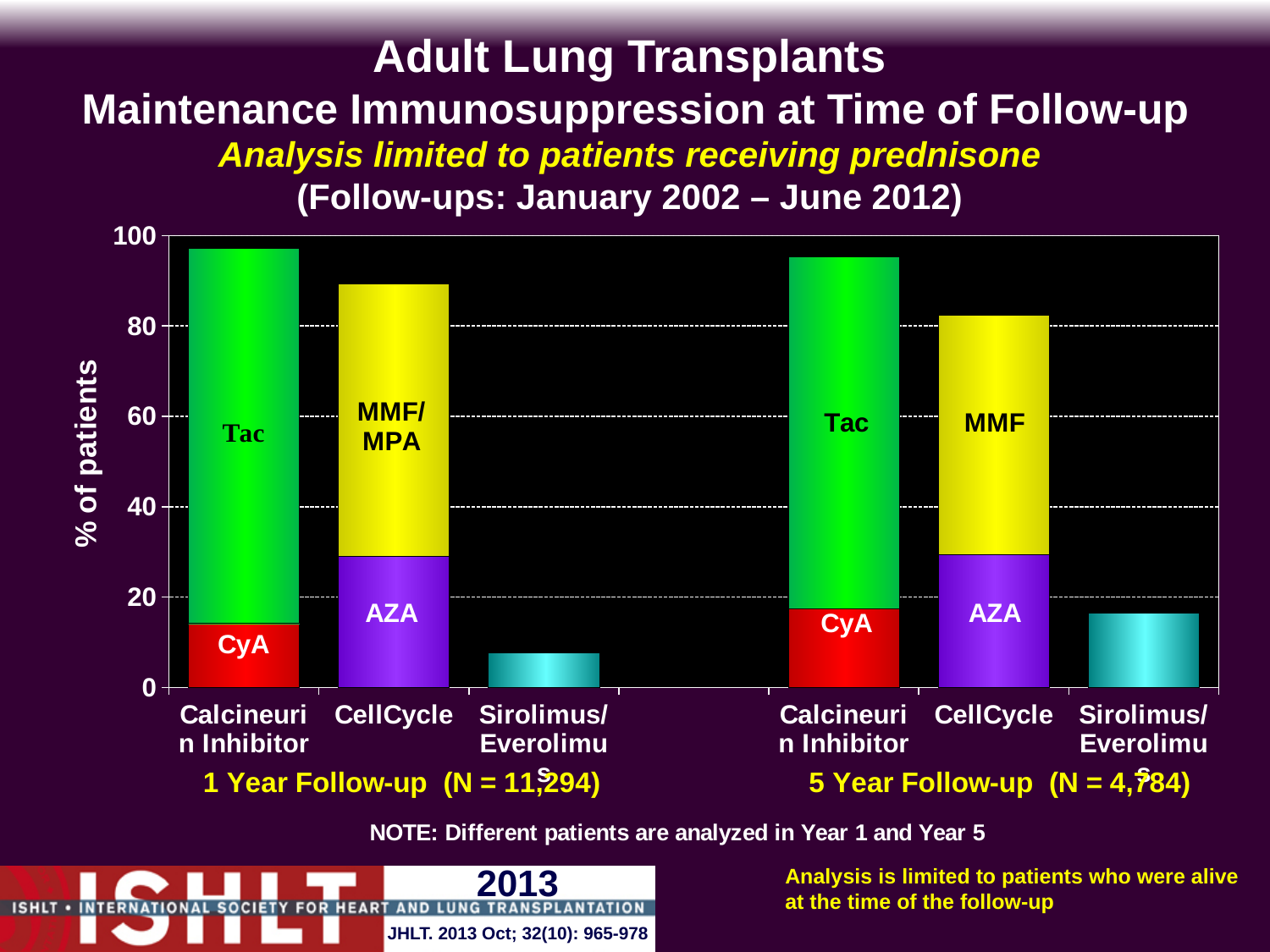
Which follow-up group has the taller CellCycle bar, 1 Year or 5 Year? 1 Year Follow-up Is the total value of the Calcineurin Inhibitor bar in the 1 Year Follow-up group greater or less than 80? greater What is the label of the y axis? % of patients Is the value for Sirolimus/Everolimus in the 5 Year Follow-up group greater or less than 20? less How many bars are plotted in total across both follow-up groups? 6 Is the value for Sirolimus/Everolimus in the 1 Year Follow-up group greater or less than 20? less Which follow-up group has the larger value for Sirolimus/Everolimus, 1 Year or 5 Year? 5 Year Follow-up What kind of chart is shown on the slide? bar chart In the 5 Year Follow-up group, which category has the shortest bar? Sirolimus/Everolimus In the 1 Year Follow-up group, which category has the tallest bar? Calcineurin Inhibitor